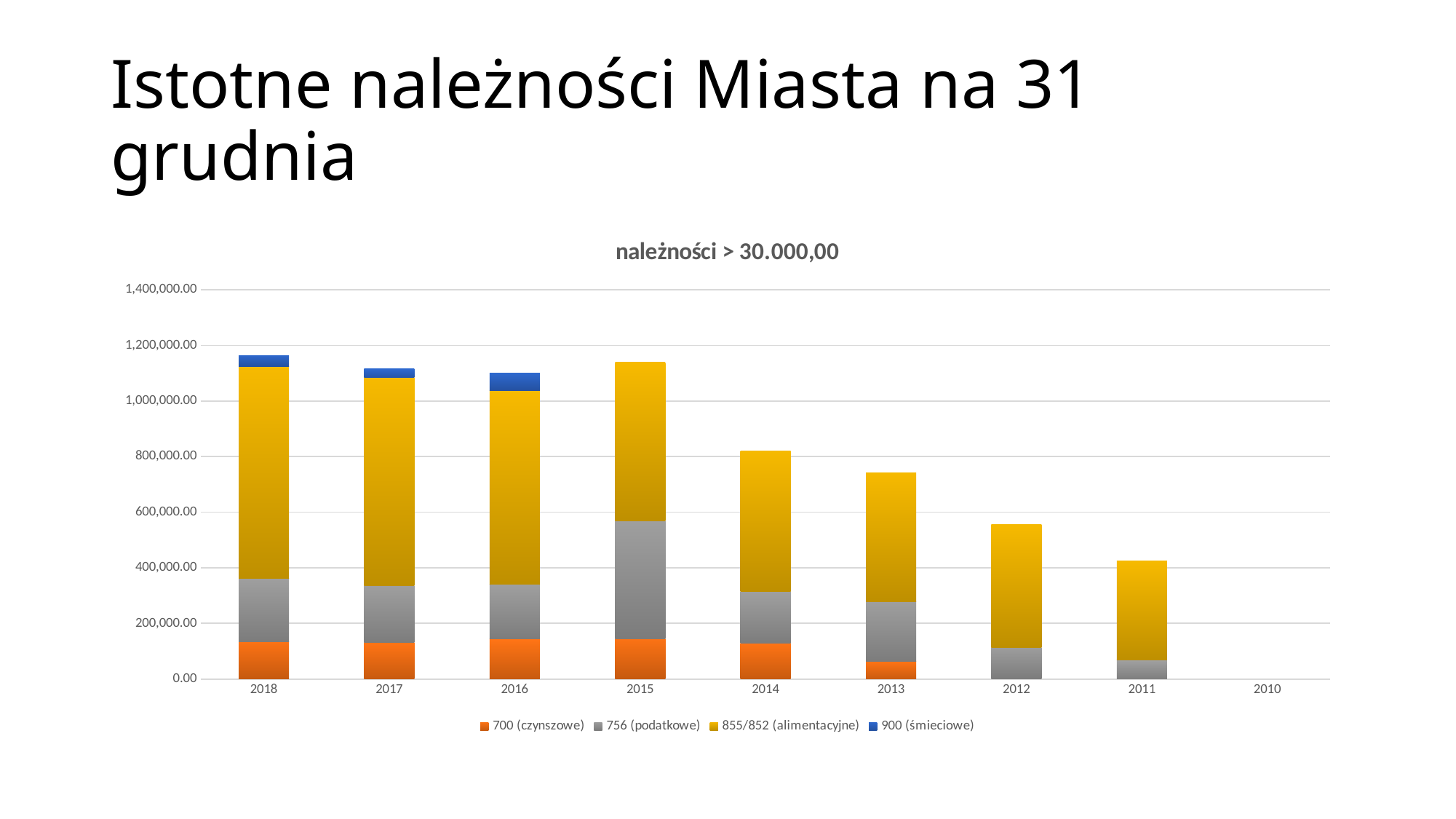
Is the total value for 2013 greater or less than 800,000.00? less Which year has no bar at all? 2010 Do the total values rise or fall from 2015 to 2011? fall How many years are shown on the x axis? 9 What kind of chart is shown on the slide? stacked bar chart What is the title of the chart? należności > 30.000,00 How many series does the legend list? 4 Which year has a larger total, 2014 or 2013? 2014 Which series is shown in blue in the legend? 900 (śmieciowe) Is the total value for 2018 greater or less than 1,000,000.00? greater Is the total value for 2011 greater or less than 600,000.00? less In which year is the 756 (podatkowe) segment the largest? 2015